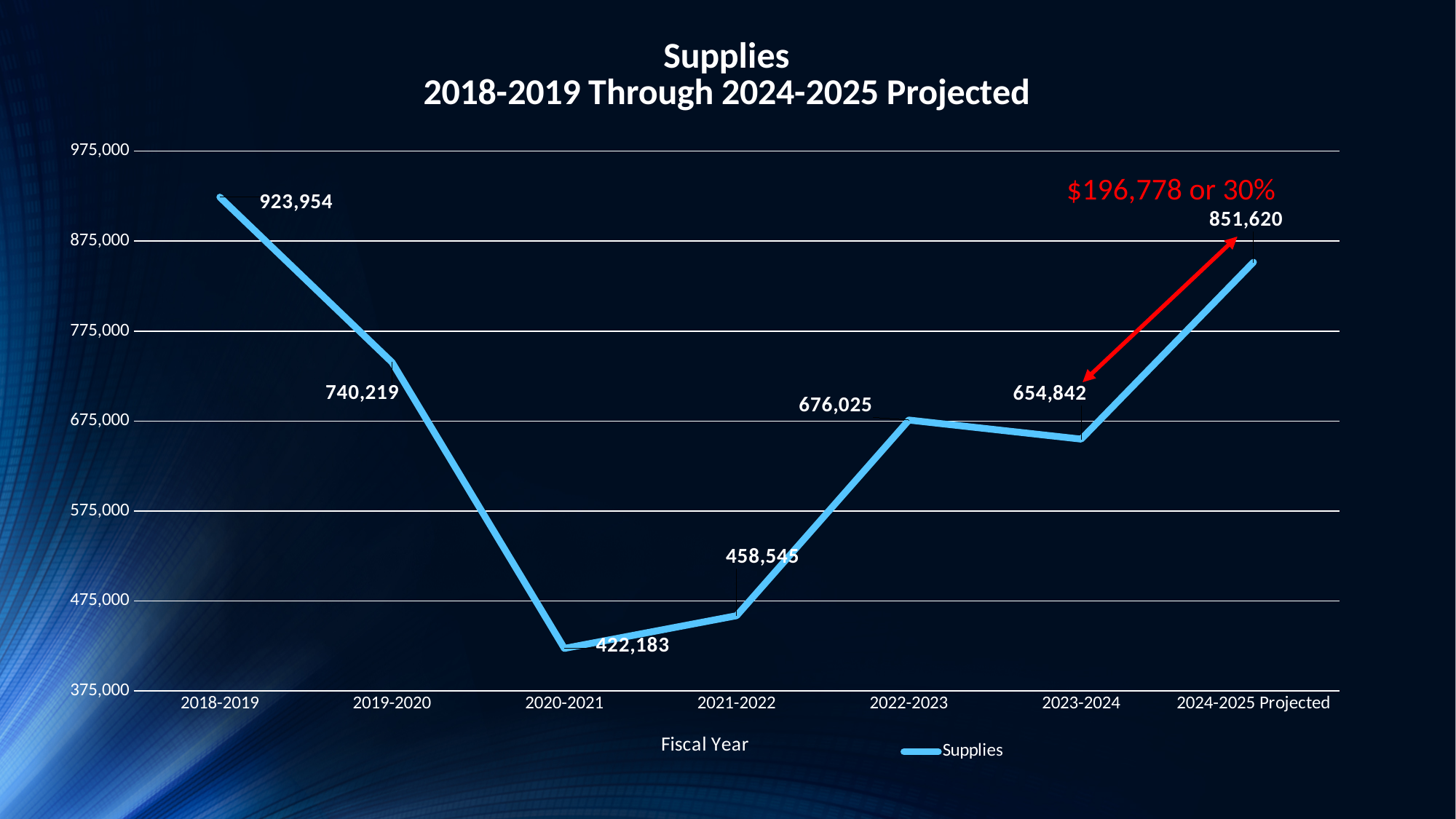
What is the Supplies value for 2018-2019? 923,954 Which fiscal year has the highest Supplies value? 2018-2019 What is the title of the chart? Supplies 2018-2019 Through 2024-2025 Projected Which fiscal year has the lowest Supplies value? 2020-2021 What is the projected Supplies value for 2024-2025? 851,620 What is the difference between the 2024-2025 Projected value and the 2023-2024 value? 196,778 Is the Supplies value for 2021-2022 greater or less than 475,000? less What is the Supplies value for 2020-2021? 422,183 What kind of chart is shown on the slide? line chart What is the Supplies value for 2022-2023? 676,025 Which is larger, the Supplies value for 2019-2020 or for 2022-2023? 2019-2020 How many fiscal years are plotted on the chart? 7